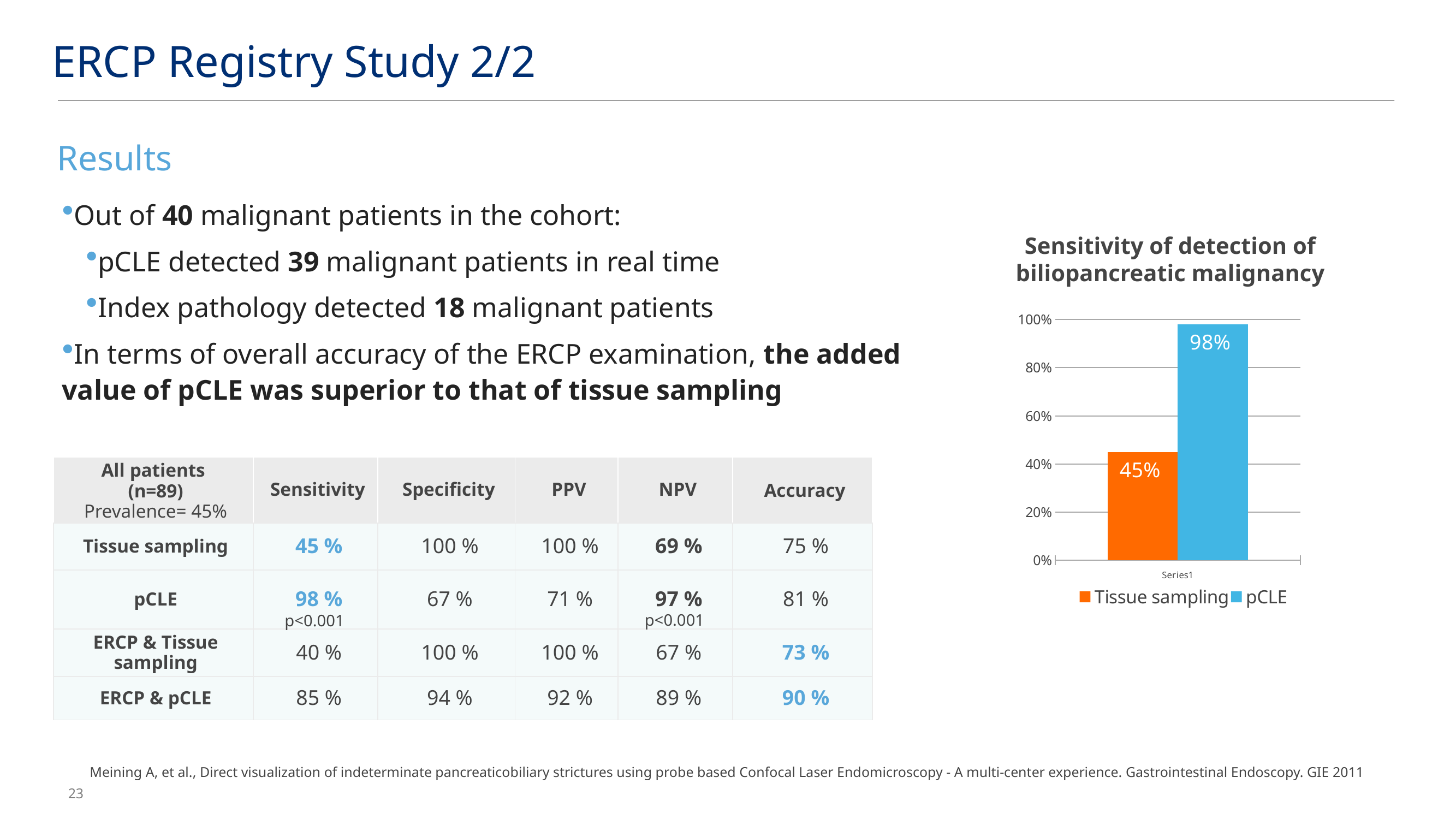
What is the difference between the pCLE and Tissue sampling values in the chart? 53% Which is larger in the chart, Tissue sampling or pCLE? pCLE How many series does the legend list? 2 What is the value for pCLE in the chart? 98% Is the value for pCLE greater or less than 80%? greater What colour is the Tissue sampling bar in the chart? orange What is the title of the chart? Sensitivity of detection of biliopancreatic malignancy Is the value for Tissue sampling greater or less than 60%? less Which series has the lowest value in the chart? Tissue sampling What is the value for Tissue sampling in the chart? 45% Which series has the highest value in the chart? pCLE What type of chart is shown on the slide? bar chart